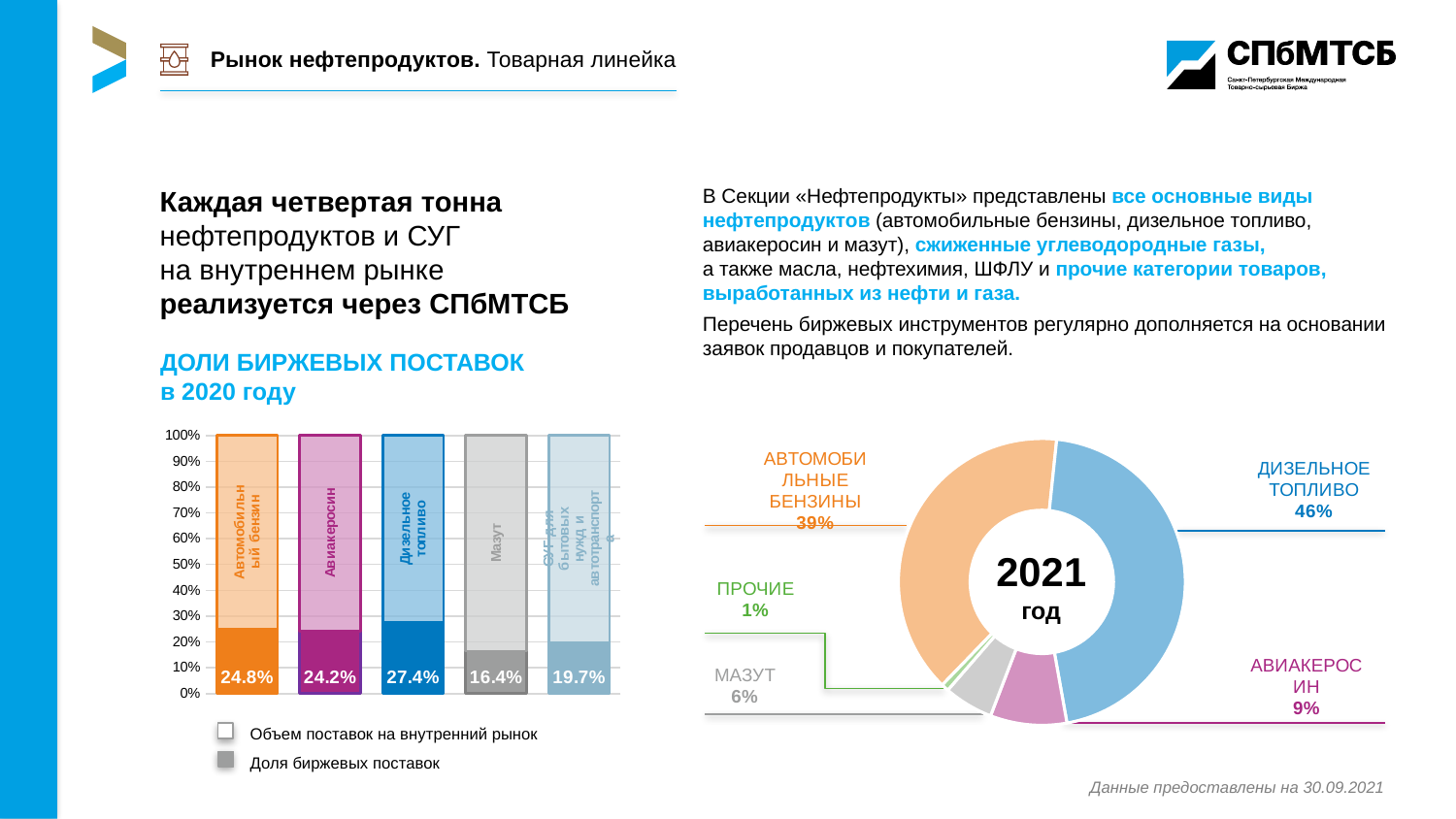
On the bar chart 'ДОЛИ БИРЖЕВЫХ ПОСТАВОК в 2020 году', how many product categories are shown? 5 On the bar chart 'ДОЛИ БИРЖЕВЫХ ПОСТАВОК в 2020 году', what is the difference between the shares for Дизельное топливо and Мазут? 11.0 percentage points On the bar chart 'ДОЛИ БИРЖЕВЫХ ПОСТАВОК в 2020 году', how many series does the legend list? 2 On the bar chart 'ДОЛИ БИРЖЕВЫХ ПОСТАВОК в 2020 году', what is the share of exchange deliveries for Мазут? 16.4% What kind of chart is the one titled 'ДОЛИ БИРЖЕВЫХ ПОСТАВОК в 2020 году'? Bar chart On the bar chart 'ДОЛИ БИРЖЕВЫХ ПОСТАВОК в 2020 году', which category has the lowest share of exchange deliveries? Мазут On the donut chart labelled '2021 год', what is the share for Авиакеросин? 9% On the bar chart 'ДОЛИ БИРЖЕВЫХ ПОСТАВОК в 2020 году', what is the share of exchange deliveries for Дизельное топливо? 27.4% On the donut chart labelled '2021 год', which is larger: the share for Автомобильные бензины or the share for Мазут? Автомобильные бензины On the donut chart labelled '2021 год', what is the share for Дизельное топливо? 46% On the bar chart 'ДОЛИ БИРЖЕВЫХ ПОСТАВОК в 2020 году', which category has the highest share of exchange deliveries? Дизельное топливо On the donut chart labelled '2021 год', which category has the smallest share? Прочие